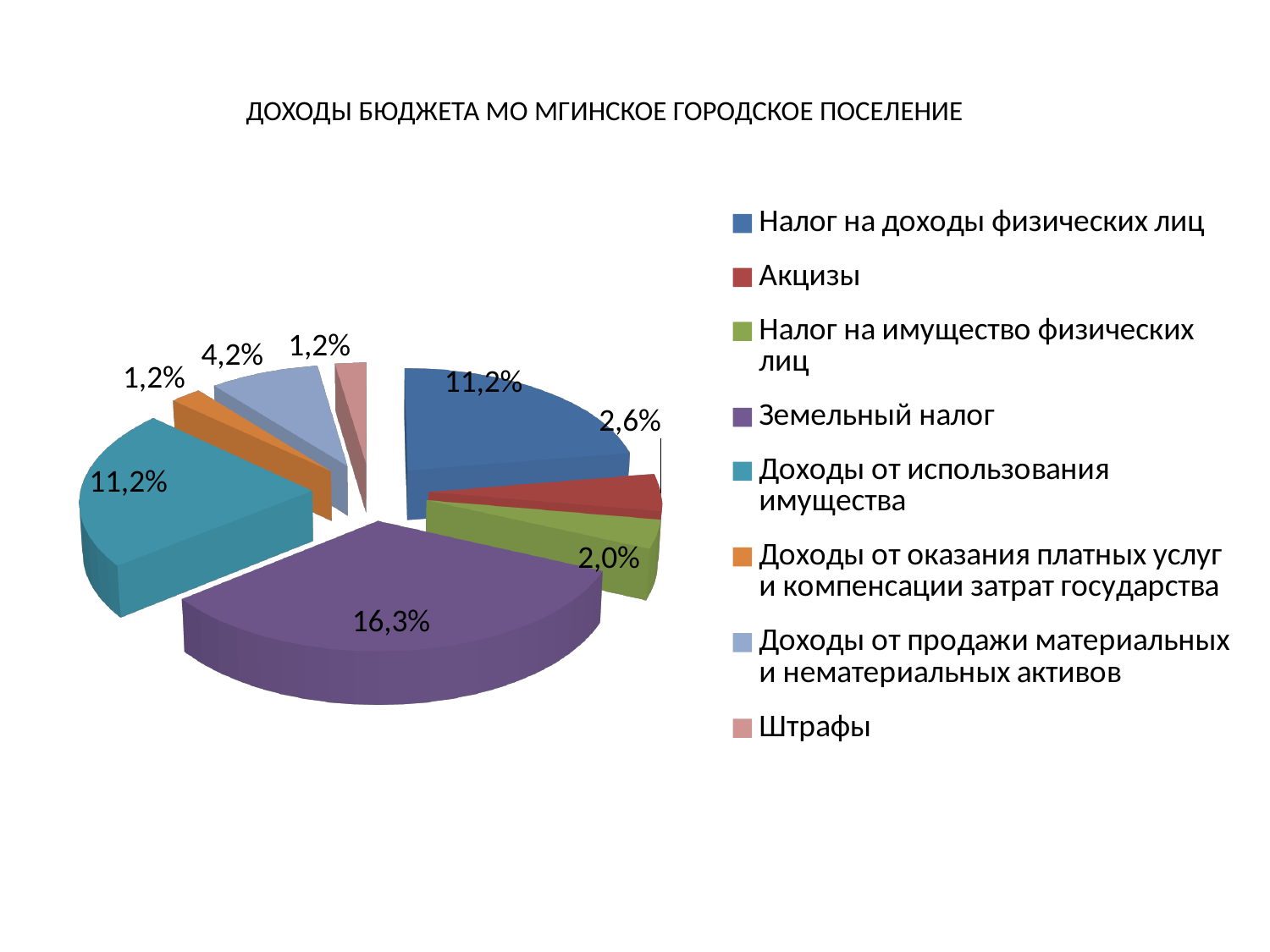
What value is shown for Доходы от продажи материальных и нематериальных активов? 4,2% What value is shown for Земельный налог? 16,3% What value is shown for Штрафы? 1,2% What value is shown for Налог на имущество физических лиц? 2,0% Which category has the largest slice? Земельный налог What kind of chart is shown on the slide? Pie chart How many categories does the legend list? 8 Which is larger, the value for Акцизы or the value for Налог на имущество физических лиц? Акцизы What is the difference between the values for Земельный налог and Доходы от использования имущества? 5,1% What value is shown for Налог на доходы физических лиц? 11,2% What is the title of the chart? ДОХОДЫ БЮДЖЕТА МО МГИНСКОЕ ГОРОДСКОЕ ПОСЕЛЕНИЕ What value is shown for Акцизы? 2,6%